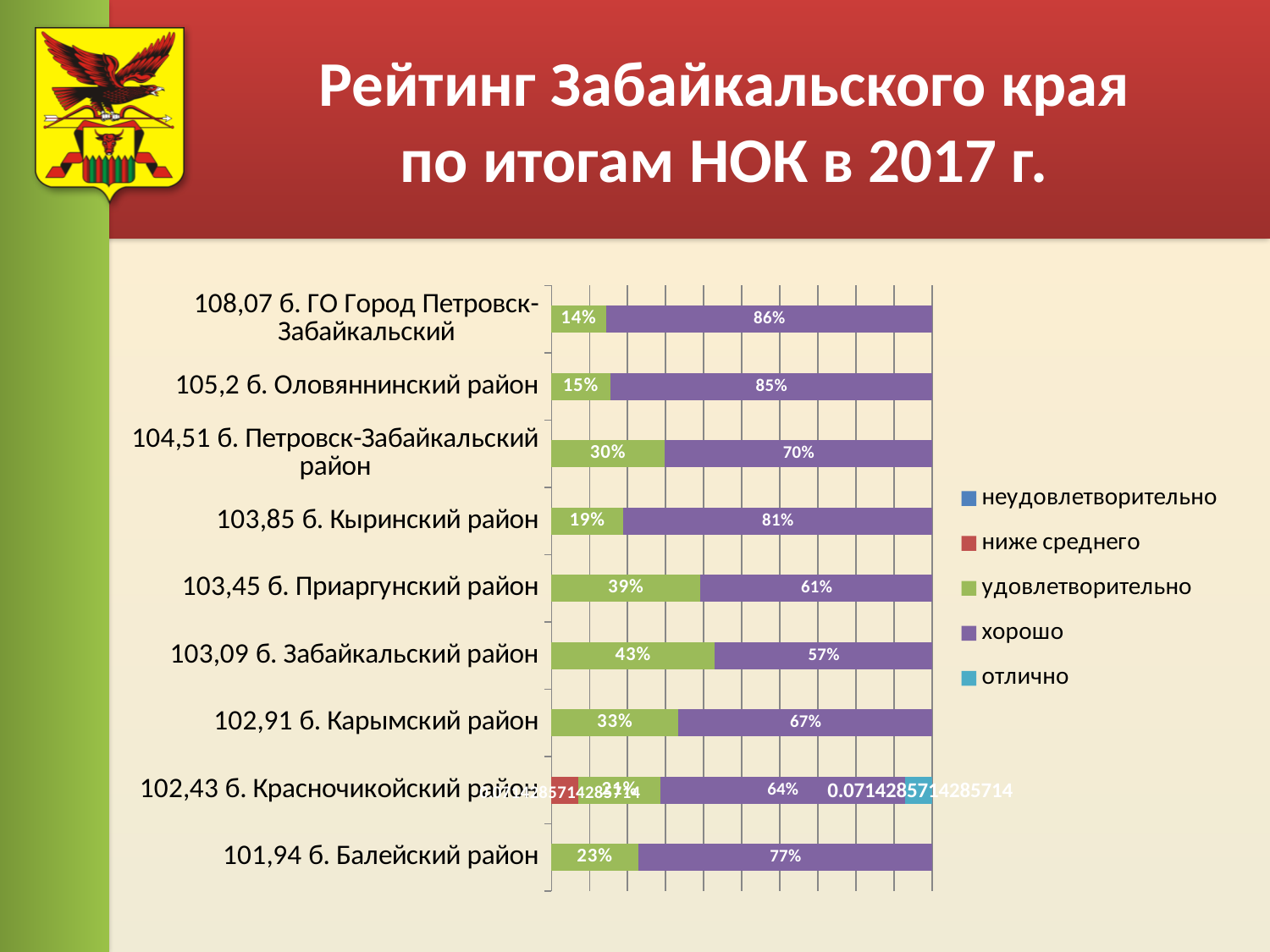
Which district has the highest "хорошо" share? 108,07 б. ГО Город Петровск-Забайкальский Which district has the highest "удовлетворительно" share? 103,09 б. Забайкальский район What is the "удовлетворительно" share for 103,09 б. Забайкальский район? 43% What is the "удовлетворительно" share for 104,51 б. Петровск-Забайкальский район? 30% Which is larger for 101,94 б. Балейский район: the "удовлетворительно" share or the "хорошо" share? хорошо Which legend entry is shown in purple? хорошо What is the "хорошо" share for 102,91 б. Карымский район? 67% How many series does the legend list? 5 What is the difference between the "хорошо" share and the "удовлетворительно" share for 103,45 б. Приаргунский район? 22% What kind of chart is shown on the slide? bar chart How many districts (categories) are plotted on the chart? 9 What is the "хорошо" share for 108,07 б. ГО Город Петровск-Забайкальский? 86%